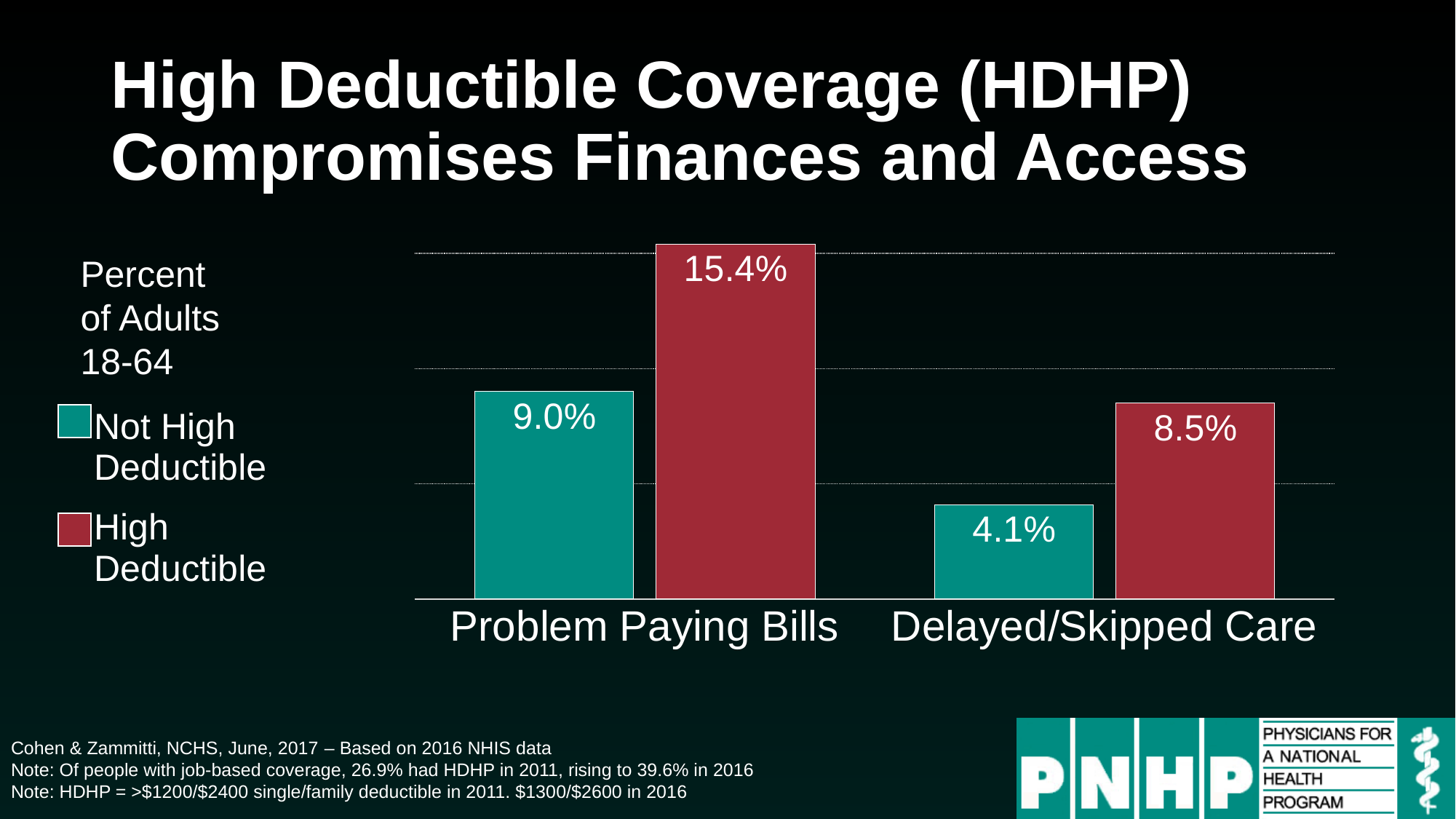
What is the value for High Deductible in the Delayed/Skipped Care category? 8.5% What is the difference between the High Deductible and Not High Deductible values for Delayed/Skipped Care? 4.4% How many categories are shown on the x axis? 2 Which bar has the lowest value on the chart? Not High Deductible, Delayed/Skipped Care Which bar has the highest value on the chart? High Deductible, Problem Paying Bills How many series does the legend list? 2 Which is larger: the Not High Deductible value for Problem Paying Bills or the High Deductible value for Delayed/Skipped Care? Not High Deductible value for Problem Paying Bills What is the difference between the High Deductible and Not High Deductible values for Problem Paying Bills? 6.4% What is the value for Not High Deductible in the Problem Paying Bills category? 9.0% What kind of chart is shown on the slide? Bar chart What is the value for Not High Deductible in the Delayed/Skipped Care category? 4.1% What is the value for High Deductible in the Problem Paying Bills category? 15.4%